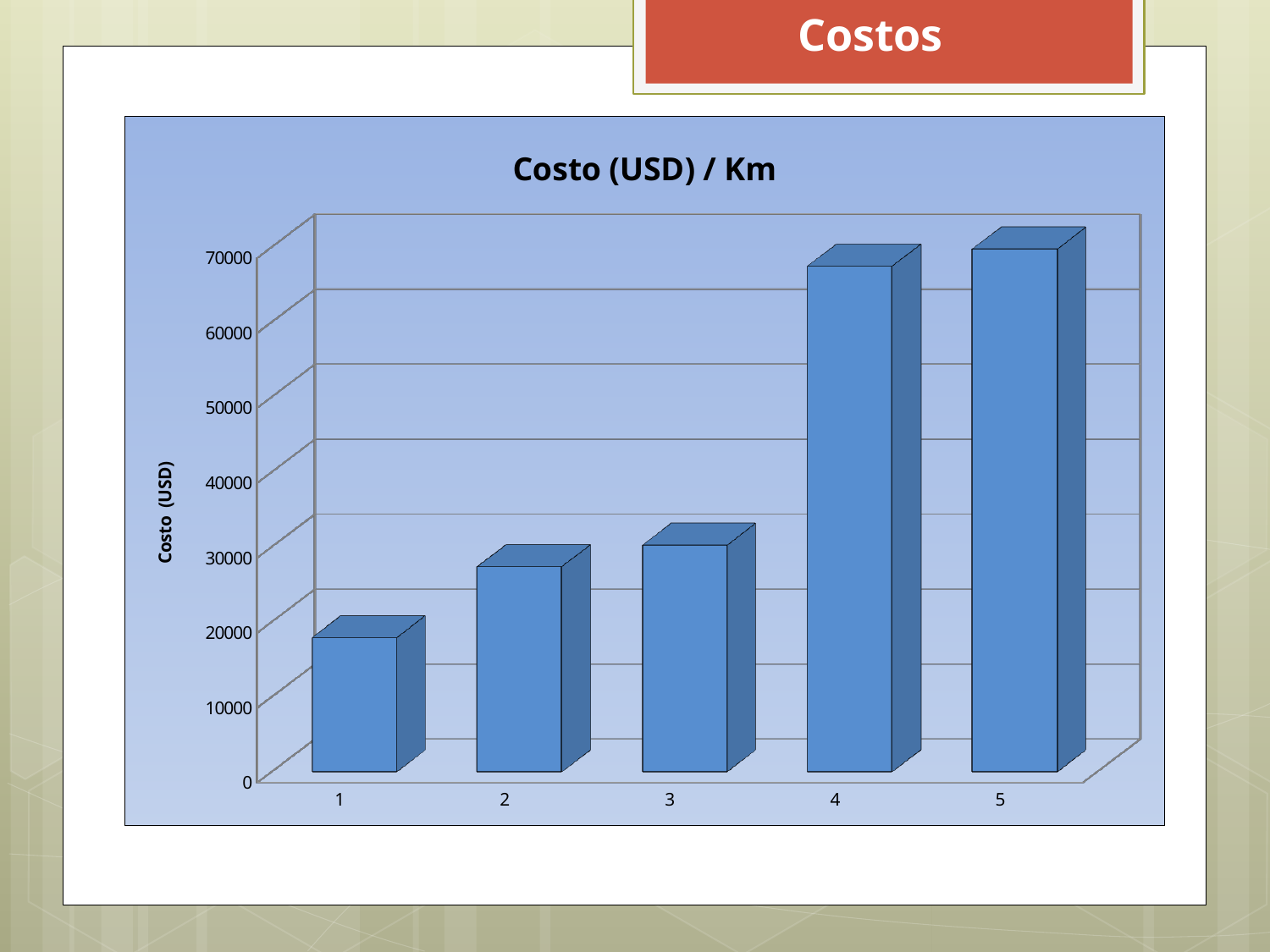
What is the title of the chart? Costo (USD) / Km Is the value for category 1 greater or less than 30000? less Is the value for category 3 greater or less than 40000? less Which has the larger value, category 1 or category 2? 2 What is the label on the vertical axis of the chart? Costo (USD) How many bars are plotted in the chart? 5 Do the values generally rise or fall from category 1 to category 5? rise Is the value for category 4 greater or less than 60000? greater What kind of chart is shown on the slide? bar chart Which category has the lowest value in the chart? 1 Which category has the highest value in the chart? 5